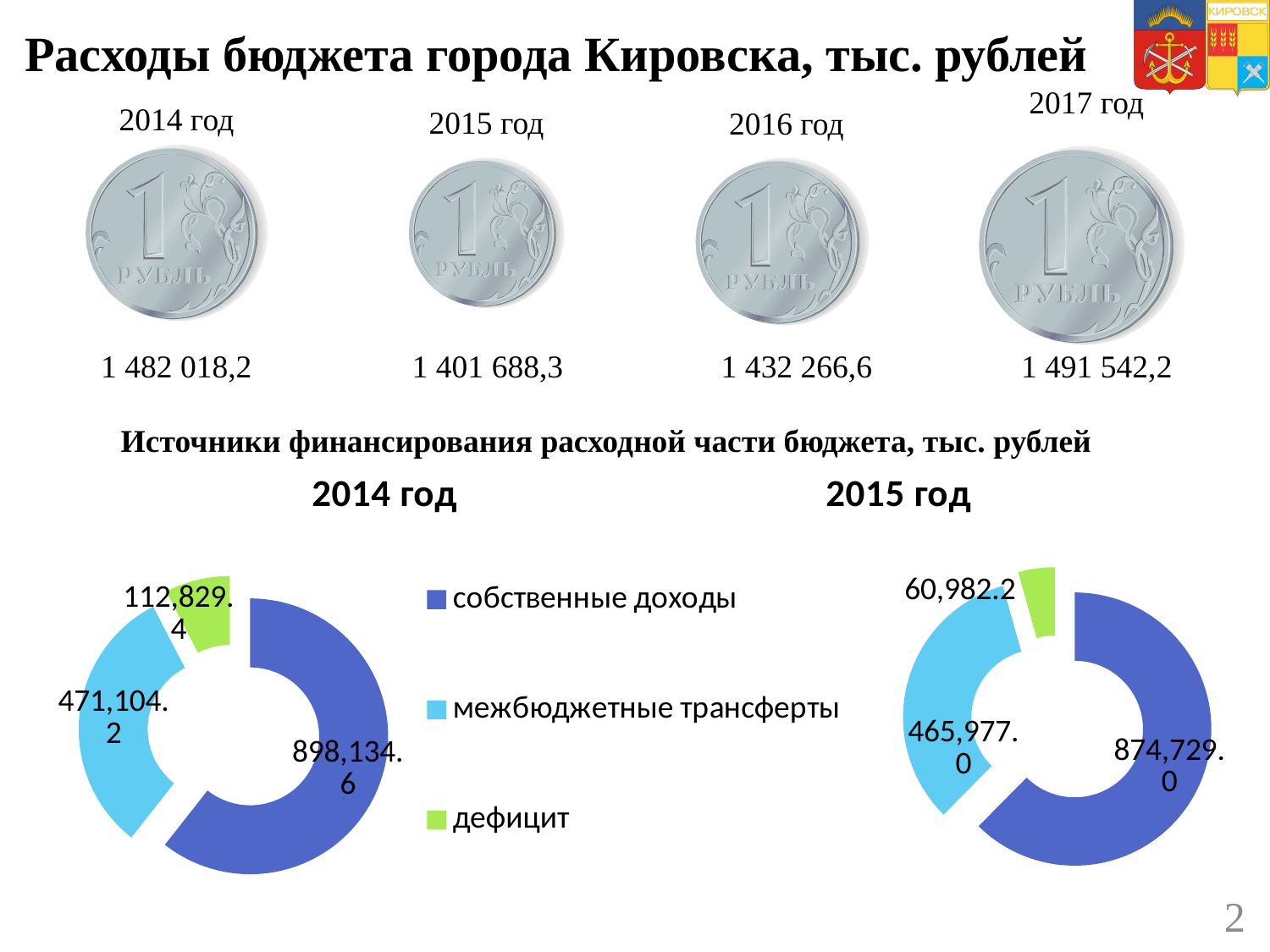
In the 2015 год chart, what is the value for дефицит? 60,982.2 In the 2014 год chart, what is the difference between собственные доходы and межбюджетные трансферты? 427,030.4 In the 2015 год chart, which category has the largest value? собственные доходы How many entries does the legend between the two charts list? 3 In the 2014 год chart, what is the value for собственные доходы? 898,134.6 In the 2014 год chart, what is the value for межбюджетные трансферты? 471,104.2 In the 2014 год chart, what is the value for дефицит? 112,829.4 Is the value for межбюджетные трансферты larger in the 2014 год chart or in the 2015 год chart? 2014 год In the 2014 год chart, which category has the smallest value? дефицит What type of chart is used for the 2014 год and 2015 год charts? doughnut chart In the 2015 год chart, what is the value for собственные доходы? 874,729.0 What is the difference between the дефицит value in the 2014 год chart and the дефицит value in the 2015 год chart? 51,847.2